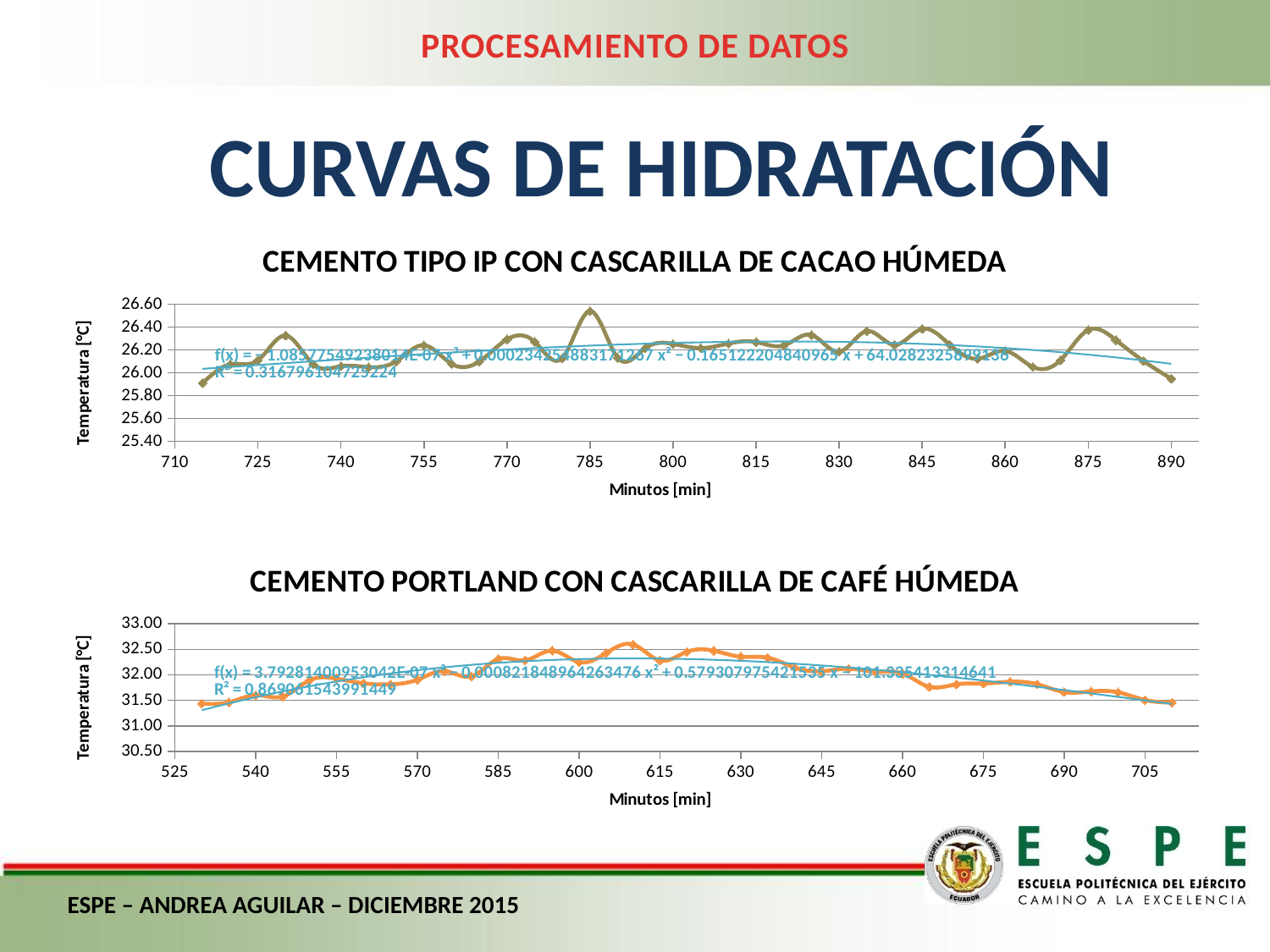
In the bottom chart (CEMENTO PORTLAND CON CASCARILLA DE CAFÉ HÚMEDA), is the temperature at 610 minutes greater or less than 32.00? greater In the bottom chart (CEMENTO PORTLAND CON CASCARILLA DE CAFÉ HÚMEDA), which is higher: the temperature at 610 minutes or at 705 minutes? 610 minutes What type of chart is the top chart titled 'CEMENTO TIPO IP CON CASCARILLA DE CACAO HÚMEDA'? Line chart In the top chart (CEMENTO TIPO IP CON CASCARILLA DE CACAO HÚMEDA), do the values rise or fall between 875 and 890 minutes? fall In the bottom chart (CEMENTO PORTLAND CON CASCARILLA DE CAFÉ HÚMEDA), is the temperature at 705 minutes greater or less than 32.00? less What type of chart is the bottom chart titled 'CEMENTO PORTLAND CON CASCARILLA DE CAFÉ HÚMEDA'? Line chart In the bottom chart (CEMENTO PORTLAND CON CASCARILLA DE CAFÉ HÚMEDA), do the values rise or fall between 660 and 705 minutes? fall What is the label of the x axis on the top chart (CEMENTO TIPO IP CON CASCARILLA DE CACAO HÚMEDA)? Minutos [min] In the top chart (CEMENTO TIPO IP CON CASCARILLA DE CACAO HÚMEDA), is the temperature at 890 minutes greater or less than 26.20? less What is the label of the y axis on the bottom chart (CEMENTO PORTLAND CON CASCARILLA DE CAFÉ HÚMEDA)? Temperatura [°C]